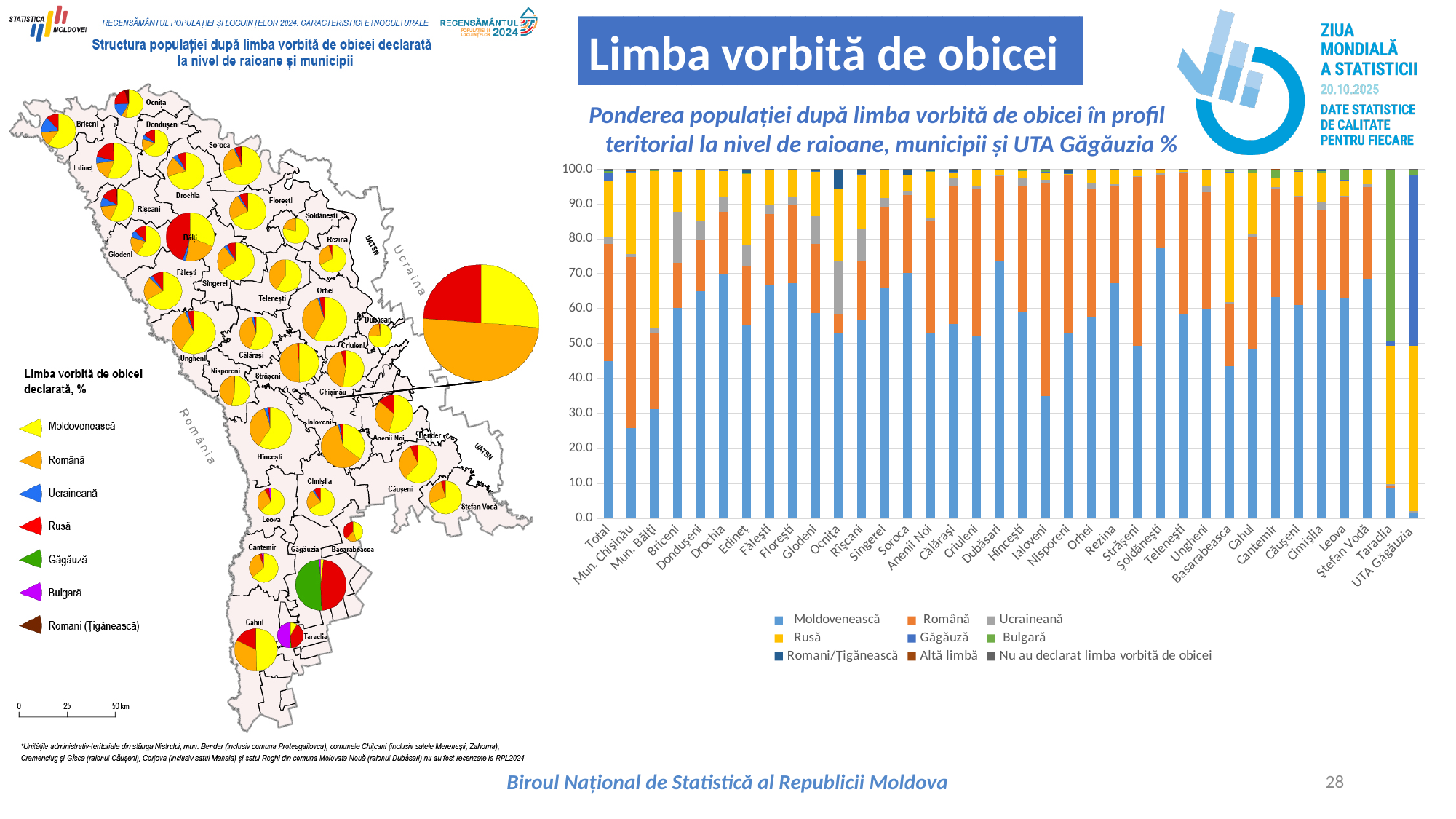
In the bar chart on the right, which category has the lowest Moldovenească value? UTA Găgăuzia In the bar chart on the right, is the Moldovenească value for Ialoveni greater or less than 40.0? less How many categories are shown along the x axis of the bar chart on the right? 36 In the bar chart on the right, is the Moldovenească value for Total greater or less than 40.0? greater How many series does the legend of the bar chart on the right list? 9 In the bar chart on the right, is the Moldovenească value for UTA Găgăuzia greater or less than 10.0? less What kind of chart is the chart on the right of the slide? Stacked bar chart In the bar chart on the right, which category has the highest Moldovenească value? Șoldănești In the bar chart on the right, which colour represents the Moldovenească series? Blue In the bar chart on the right, which has the larger Moldovenească value, Hîncești or Ialoveni? Hîncești